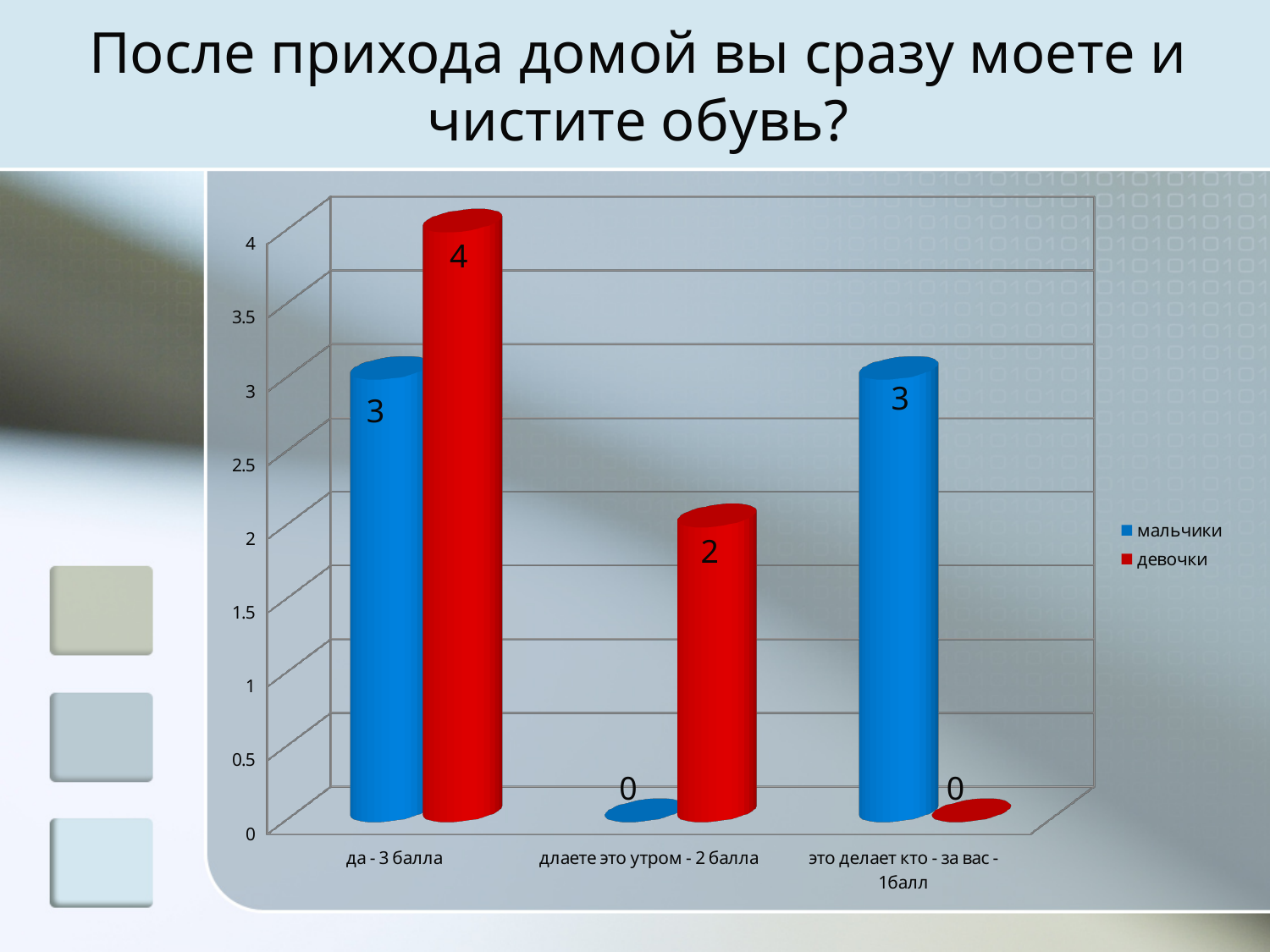
What is the value for девочки in the category "длаете это утром - 2 балла"? 2 What is the value for мальчики in the category "это делает кто - за вас - 1балл"? 3 What kind of chart is shown on the slide? bar chart What is the value for мальчики in the category "длаете это утром - 2 балла"? 0 In the category "это делает кто - за вас - 1балл", which series has the larger value, мальчики or девочки? мальчики What is the difference between the девочки and мальчики values in the category "да - 3 балла"? 1 What is the value for девочки in the category "да - 3 балла"? 4 Which category has the highest value for девочки? да - 3 балла Which category has the lowest value for мальчики? длаете это утром - 2 балла What is the value for мальчики in the category "да - 3 балла"? 3 How many series does the legend list? 2 How many categories are shown on the x axis? 3